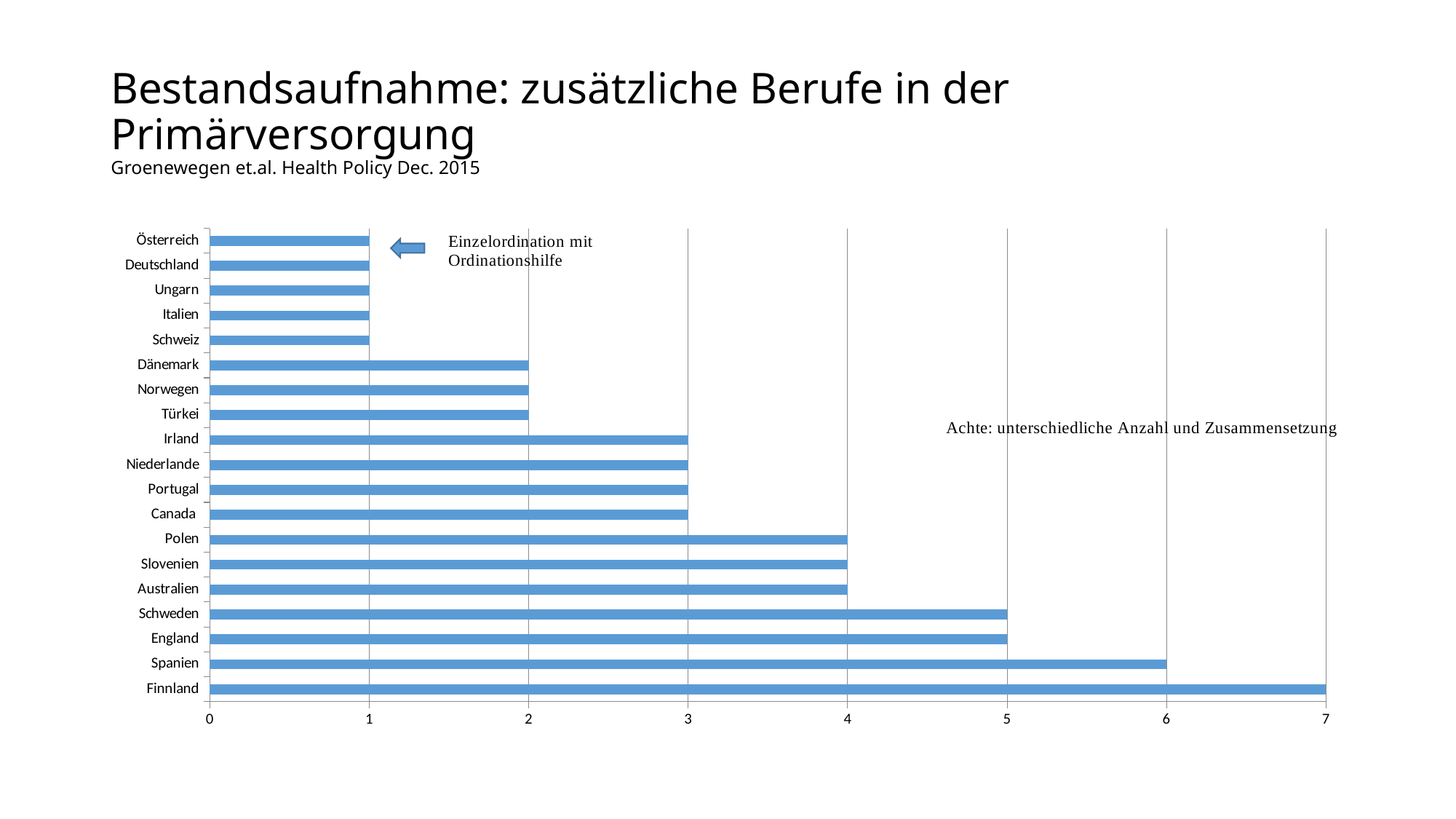
What is the difference between the values for Finnland and Spanien? 1 Which has a larger value, Schweden or Spanien? Spanien Is the value for Australien greater or less than 3? greater What kind of chart is shown on the slide? bar chart How many countries are listed on the chart? 19 Which country has the highest value on the chart? Finnland What text does the arrow next to the Österreich bar point to? Einzelordination mit Ordinationshilfe What is the value for Finnland? 7 What is the value for Österreich? 1 What is the value for Spanien? 6 What is the value for Dänemark? 2 What is the value for Polen? 4